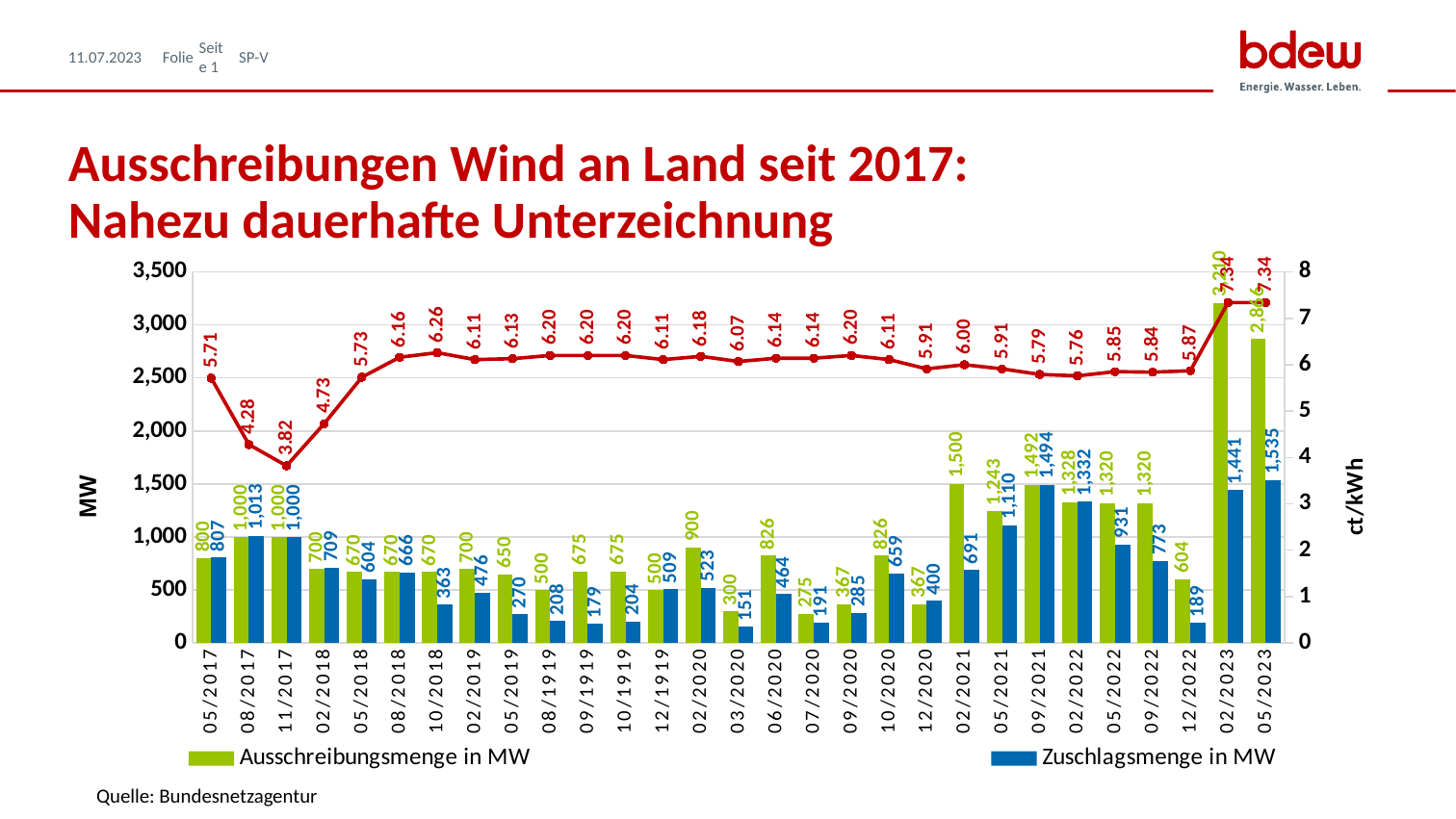
What is the Ausschreibungsmenge in MW for 02/2021? 1,500 What is the difference between the Ausschreibungsmenge and the Zuschlagsmenge for 02/2021? 809 How many periods are shown on the x axis? 29 Which period has the lowest Zuschlagsmenge in MW? 03/2020 What unit is shown on the right-hand axis? ct/kWh What is the difference between the Ausschreibungsmenge and the Zuschlagsmenge for 05/2022? 389 What value does the red line show for 11/2017? 3.82 Which period has the highest Ausschreibungsmenge in MW? 02/2023 What is the Zuschlagsmenge in MW for 05/2023? 1,535 Is the Zuschlagsmenge for 02/2023 greater or less than 1,000 MW? greater How many series does the legend list? 2 For 12/2022, which is larger: the Ausschreibungsmenge or the Zuschlagsmenge? Ausschreibungsmenge